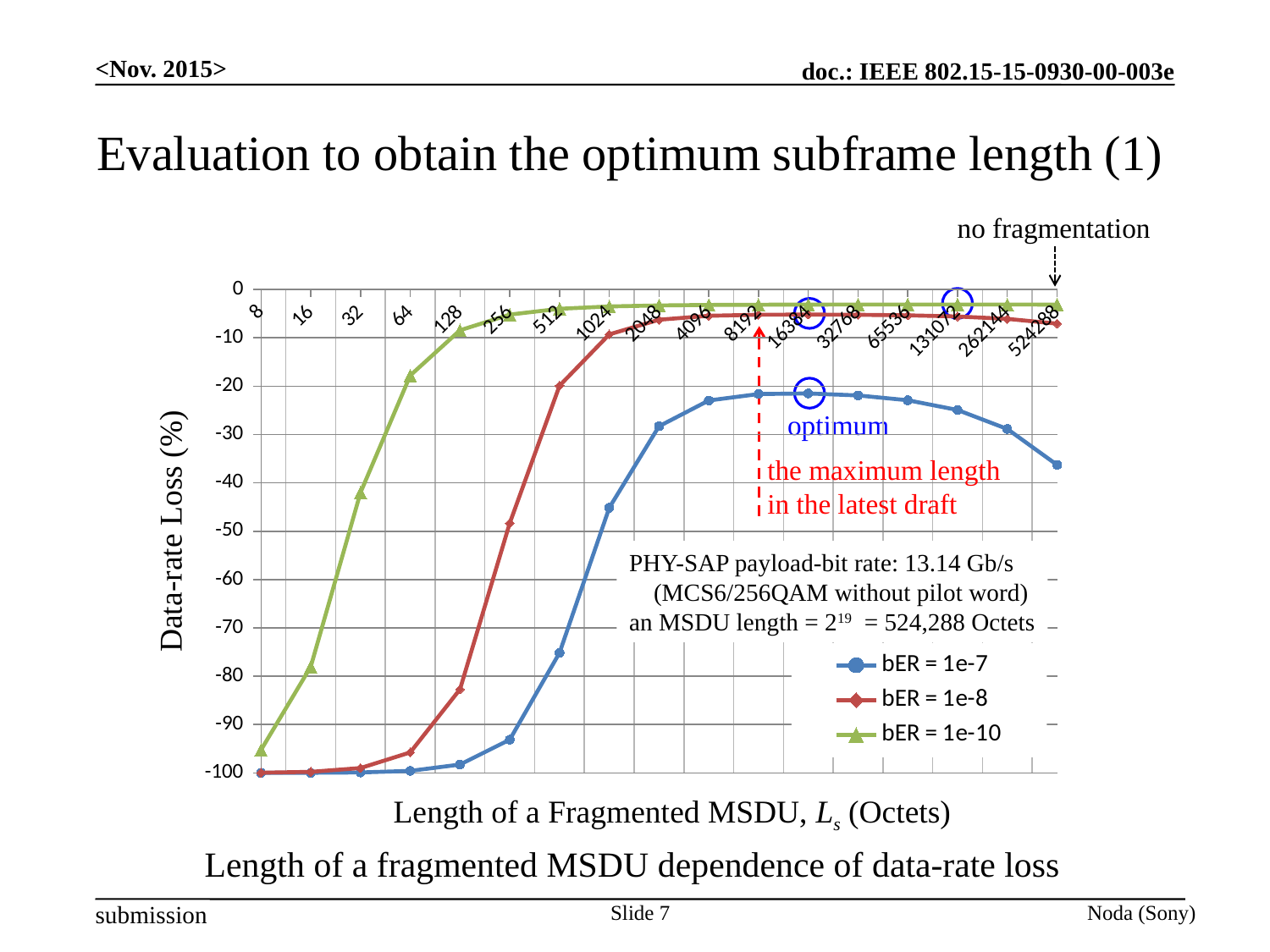
How many points are plotted along the x axis for each series? 17 Which series are listed in the legend? bER = 1e-7, bER = 1e-8, bER = 1e-10 Is the value for bER = 1e-7 at 512 greater or less than -70? less What is the label of the y axis? Data-rate Loss (%) Is the value for bER = 1e-10 at 64 greater or less than -20? greater At 256 octets, which series has the higher value, bER = 1e-7 or bER = 1e-10? bER = 1e-10 How many series does the legend list? 3 Is the value for bER = 1e-8 at 1024 greater or less than -20? greater What kind of chart is shown on the slide? line chart Does the bER = 1e-7 series rise or fall from 8 to 8192 octets? rise